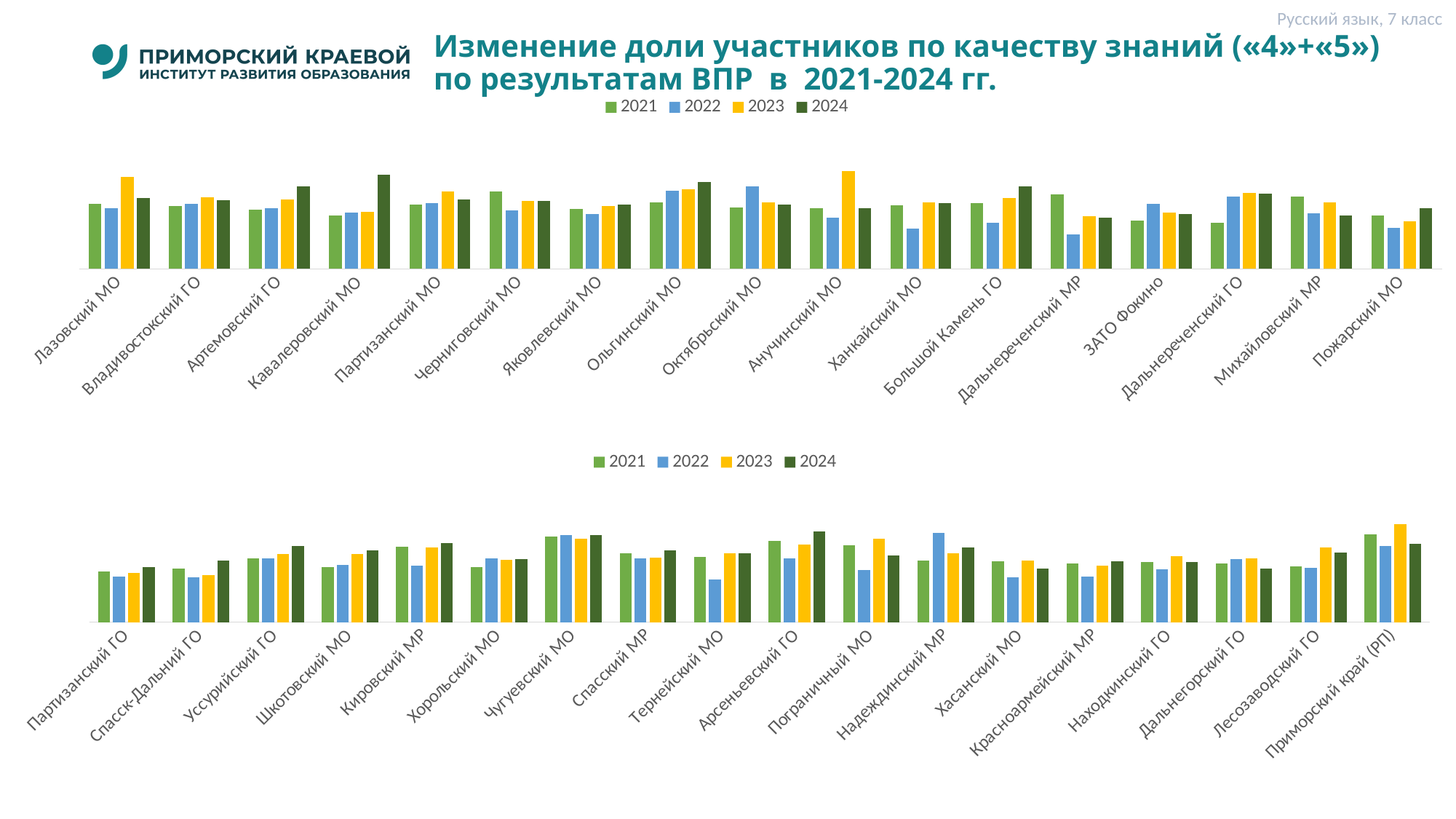
In the top chart, which year has the highest bar for Анучинский МО? 2023 What kind of chart is the top chart on the slide? bar chart In the bottom chart, for Пограничный МО, is the 2023 bar or the 2022 bar taller? 2023 In the bottom chart, which year has the highest bar for Надеждинский МР? 2022 In the top chart, for Лазовский МО, is the 2023 bar or the 2022 bar taller? 2023 How many categories are shown on the x axis of the bottom chart? 18 In the bottom chart, which year has the lowest bar for Тернейский МО? 2022 In the top chart, which year has the highest bar for Кавалеровский МО? 2024 How many series does the legend of the top chart list? 4 How many categories are shown on the x axis of the top chart? 17 Which series is shown in yellow in the legend of the top chart? 2023 In the top chart, which year has the lowest bar for Дальнереченский МР? 2022